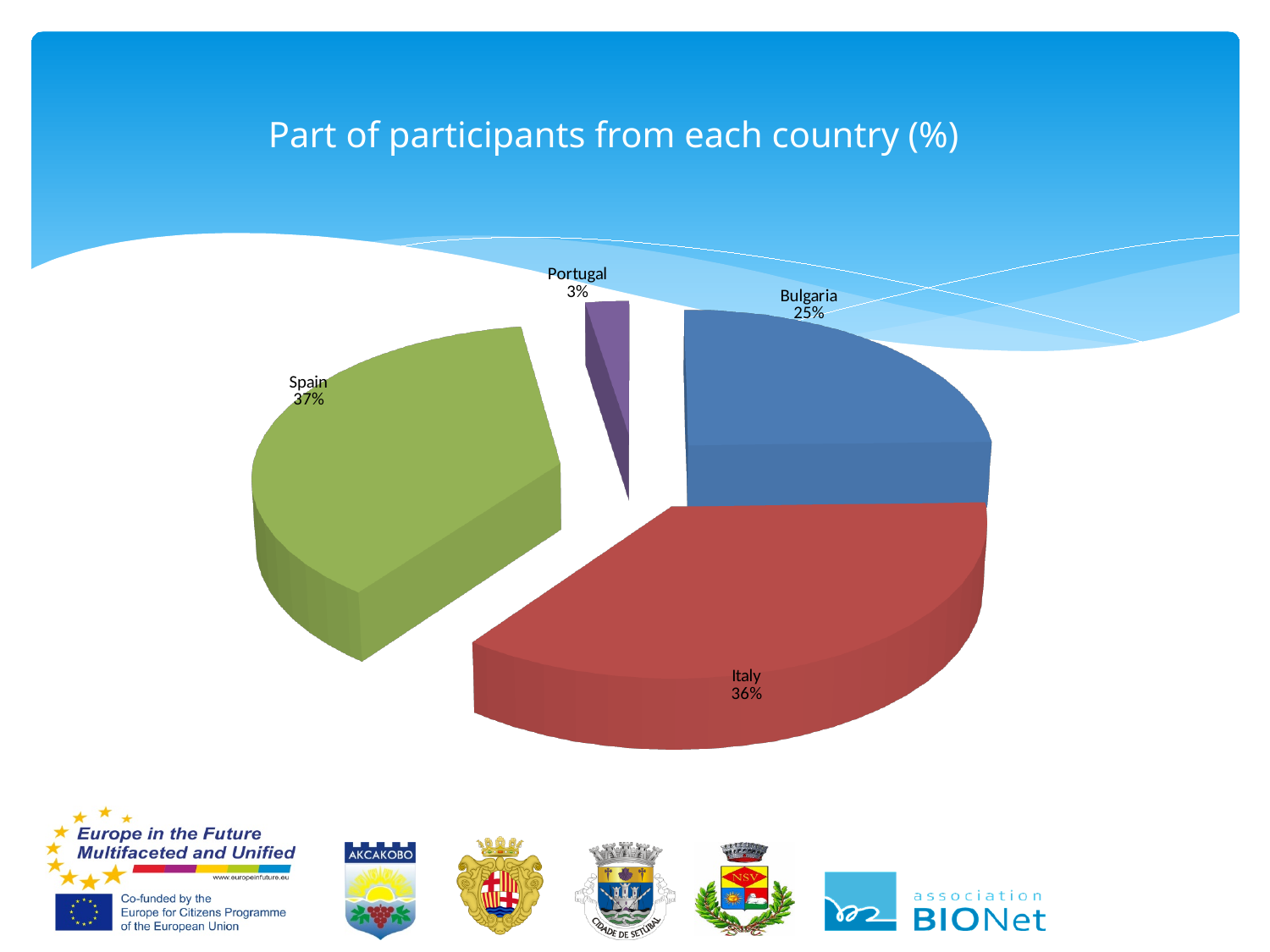
What share of participants came from Italy? 36% What is the difference in percentage points between Italy's share and Portugal's share? 33 Which country has the smallest share of participants? Portugal What kind of chart is shown on the slide? Pie chart How many countries are shown in the pie chart? 4 What share of participants came from Portugal? 3% Which country has the largest share of participants according to the data labels? Spain What share of participants came from Spain? 37% What share of participants came from Bulgaria? 25% What is the title of the chart? Part of participants from each country (%) Which has a larger share of participants, Bulgaria or Portugal? Bulgaria What is the difference in percentage points between Spain's share and Bulgaria's share? 12